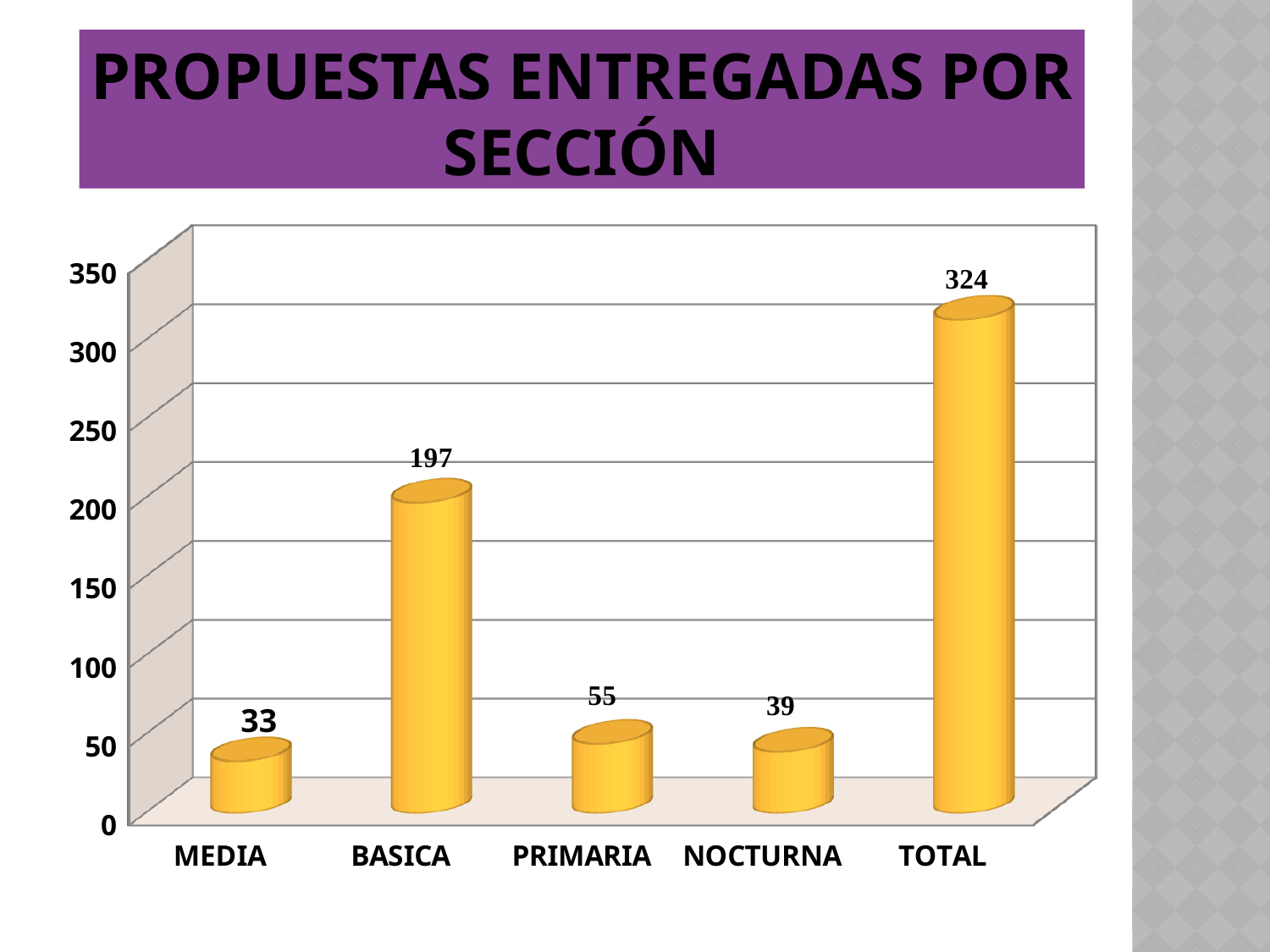
What kind of chart is shown on the slide? bar chart What is the value for NOCTURNA? 39 What is the value for MEDIA? 33 Which category has the highest value? TOTAL What is the value for PRIMARIA? 55 What is the title of the slide? PROPUESTAS ENTREGADAS POR SECCIÓN Is the value for BASICA greater or less than 150? greater How many categories are shown on the x axis? 5 What is the value for BASICA? 197 Which category has the lowest value? MEDIA Which is larger, the value for PRIMARIA or the value for NOCTURNA? PRIMARIA What is the difference between the values for BASICA and PRIMARIA? 142